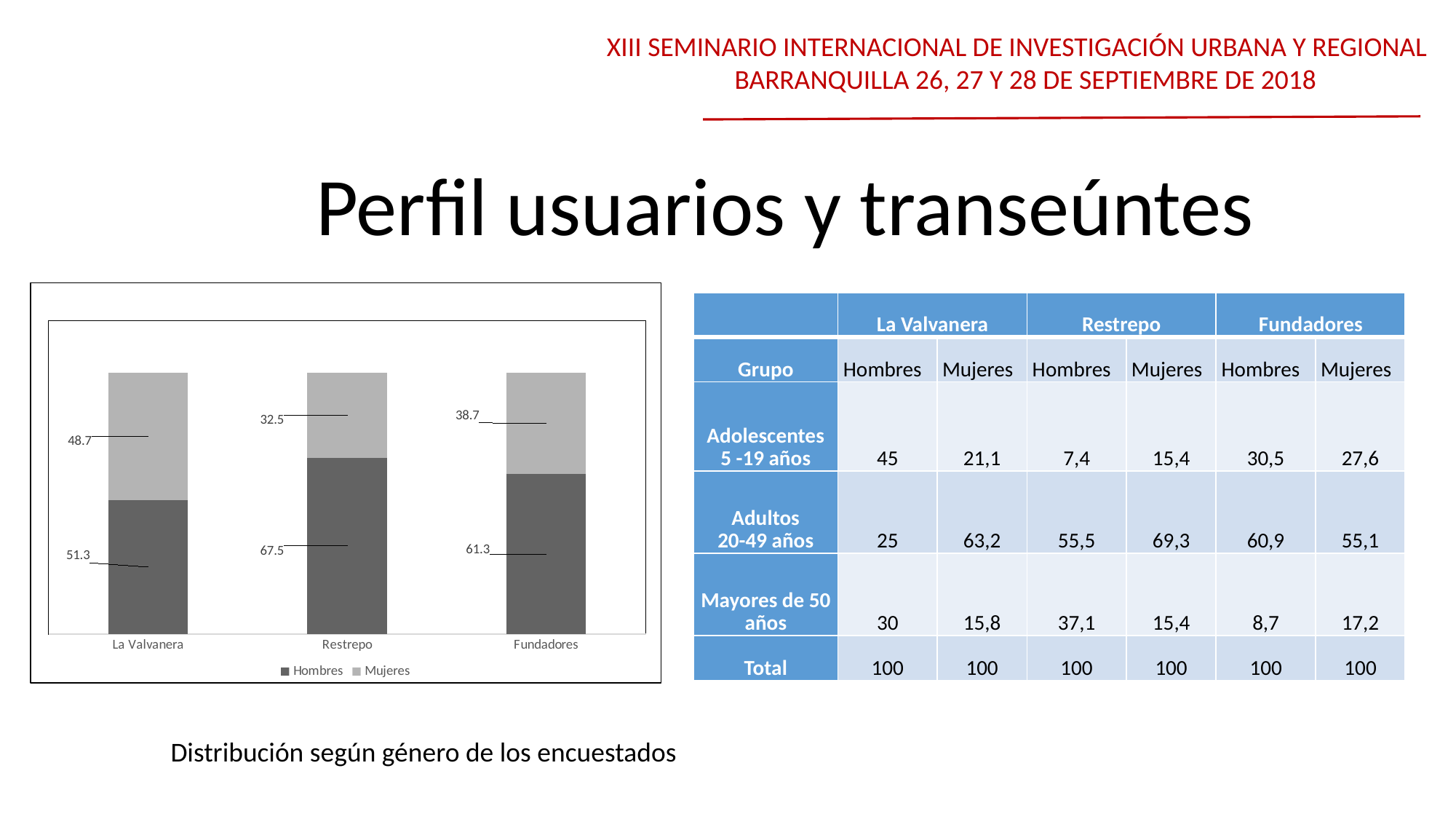
In the bar chart, what is the value for Hombres at Restrepo? 67.5 In the bar chart, which is larger at La Valvanera: Hombres or Mujeres? Hombres How many series does the legend of the bar chart list? 2 In the bar chart, what is the difference between the Hombres and Mujeres values at Restrepo? 35 In the bar chart, what is the value for Mujeres at Fundadores? 38.7 In the bar chart, what is the value for Mujeres at La Valvanera? 48.7 What kind of chart is shown on the left of the slide? Stacked bar chart In the bar chart, what is the total of the stacked bar for Fundadores? 100 In the bar chart, what is the value for Hombres at Fundadores? 61.3 In the bar chart, which location has the lowest value for Mujeres? Restrepo In the bar chart, which location has the highest value for Hombres? Restrepo How many locations are shown on the x axis of the bar chart? 3